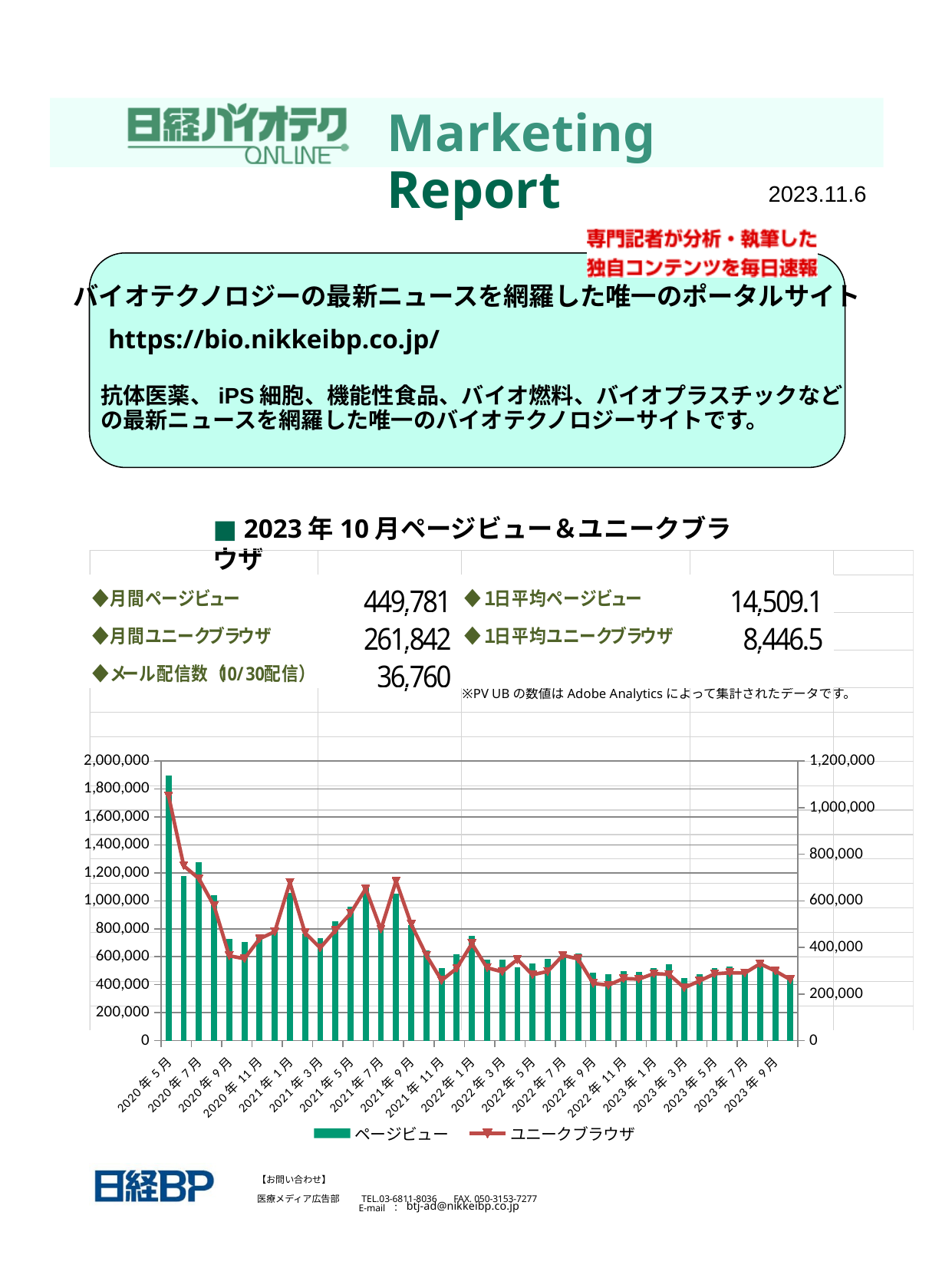
Is the page view value for 2020年5月 greater or less than 1,600,000? greater Which month has the highest page view (ページビュー) bar? 2020年5月 What kind of chart is shown on the slide? A combination bar and line chart How many series does the chart legend list? 2 Which month has the larger page view bar, 2020年7月 or 2021年1月? 2020年7月 What is the maximum value shown on the right-hand axis of the chart? 1,200,000 Is the unique browser (ユニークブラウザ) value for 2020年5月 greater or less than 800,000 on the right axis? greater What is the title of the chart? 2023年10月ページビュー＆ユニークブラウザ Is the unique browser value for 2021年1月 greater or less than 500,000 on the right axis? greater Do page views generally rise or fall from 2020年5月 to 2023年9月? fall